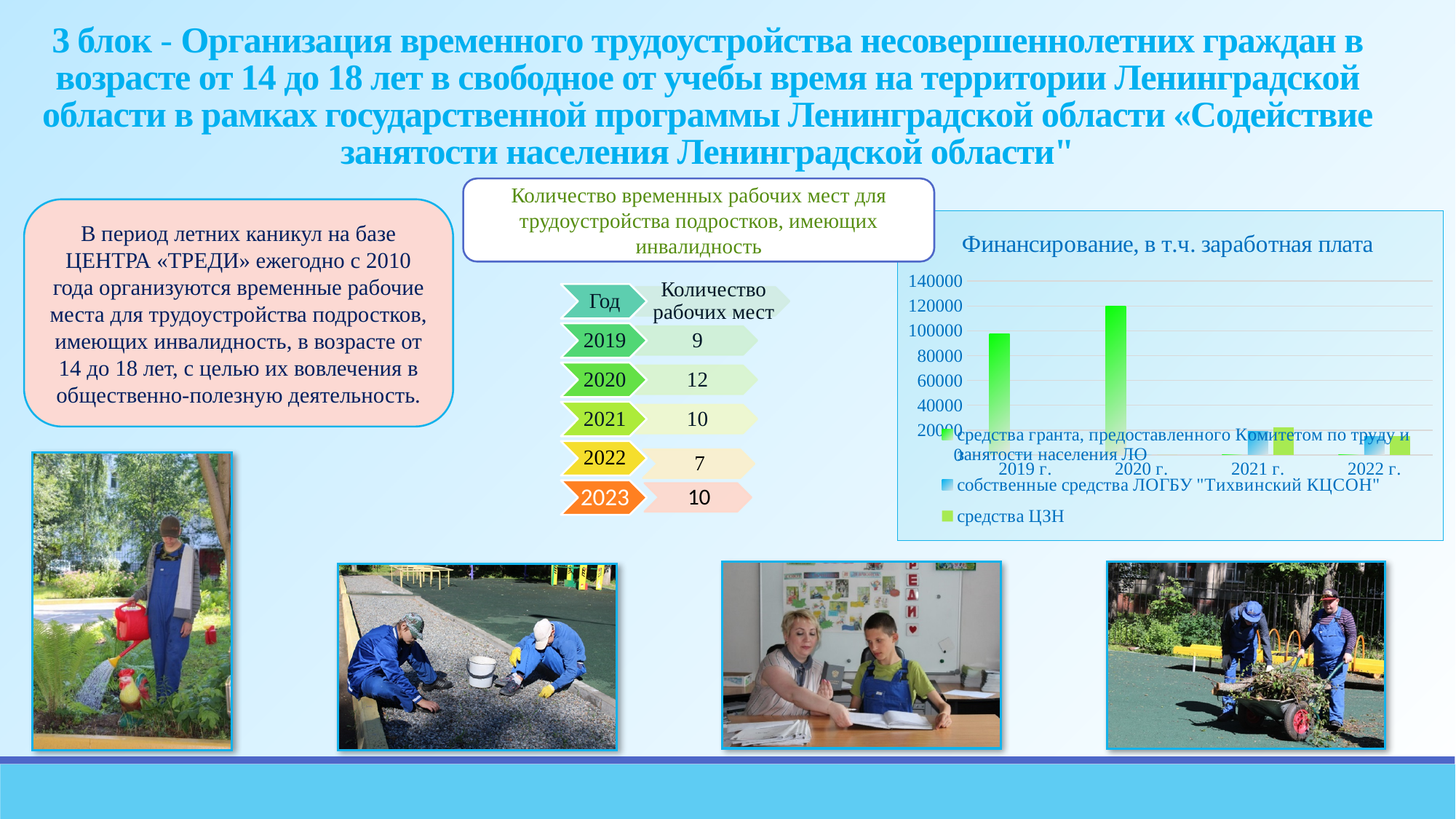
In the "Финансирование, в т.ч. заработная плата" chart, does the tall bar rise or fall from 2019 г. to 2020 г.? rise In the "Финансирование, в т.ч. заработная плата" chart, which year has the tallest bar? 2020 г. How many series does the legend of the "Финансирование, в т.ч. заработная плата" chart list? 3 In the "Финансирование, в т.ч. заработная плата" chart, is the tall bar for 2019 г. greater or less than 80000? greater What is the title of the bar chart on the right side of the slide? Финансирование, в т.ч. заработная плата What kind of chart is shown under the title "Финансирование, в т.ч. заработная плата"? bar chart In the "Финансирование, в т.ч. заработная плата" chart, is the tall bar for 2019 г. greater or less than 120000? less In the "Финансирование, в т.ч. заработная плата" chart, which is larger: the tall bar for 2019 г. or the tall bar for 2020 г.? 2020 г. In the "Финансирование, в т.ч. заработная плата" chart, is the tall bar for 2020 г. greater or less than 100000? greater How many year categories are shown on the x axis of the "Финансирование, в т.ч. заработная плата" chart? 4 What is the highest tick value shown on the vertical axis of the "Финансирование, в т.ч. заработная плата" chart? 140000